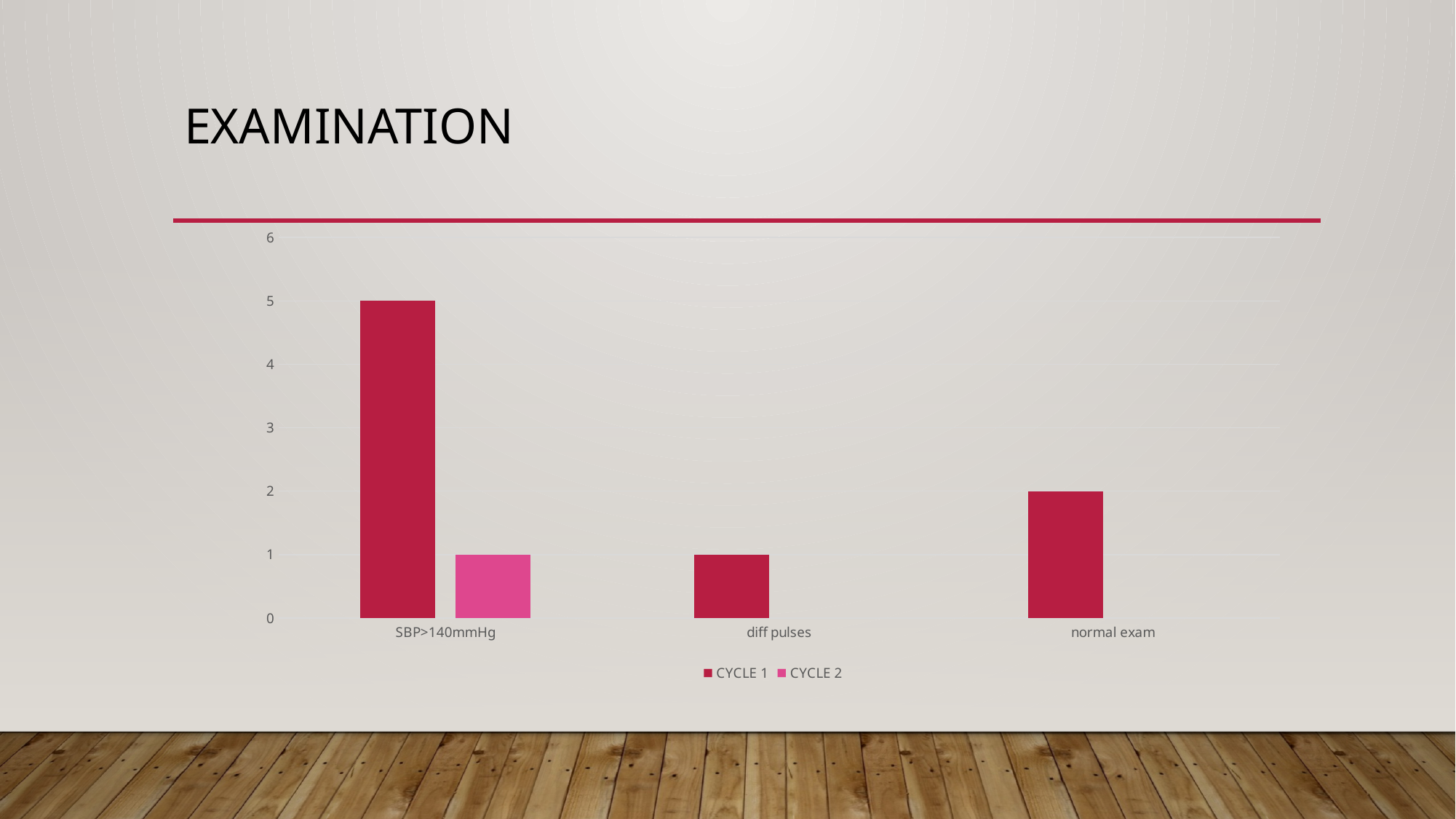
How many series does the legend list? 2 How many categories are shown on the x axis? 3 What is the title of the slide containing the chart? EXAMINATION What is the difference between the CYCLE 1 and CYCLE 2 values for SBP>140mmHg? 4 Which is larger for CYCLE 1: normal exam or diff pulses? normal exam What type of chart is shown on the slide? bar chart What is the CYCLE 1 value for SBP>140mmHg? 5 What is the CYCLE 1 value for normal exam? 2 What is the CYCLE 2 value for SBP>140mmHg? 1 What is the CYCLE 1 value for diff pulses? 1 Which category has the highest CYCLE 1 value? SBP>140mmHg Which category has the lowest CYCLE 1 value? diff pulses